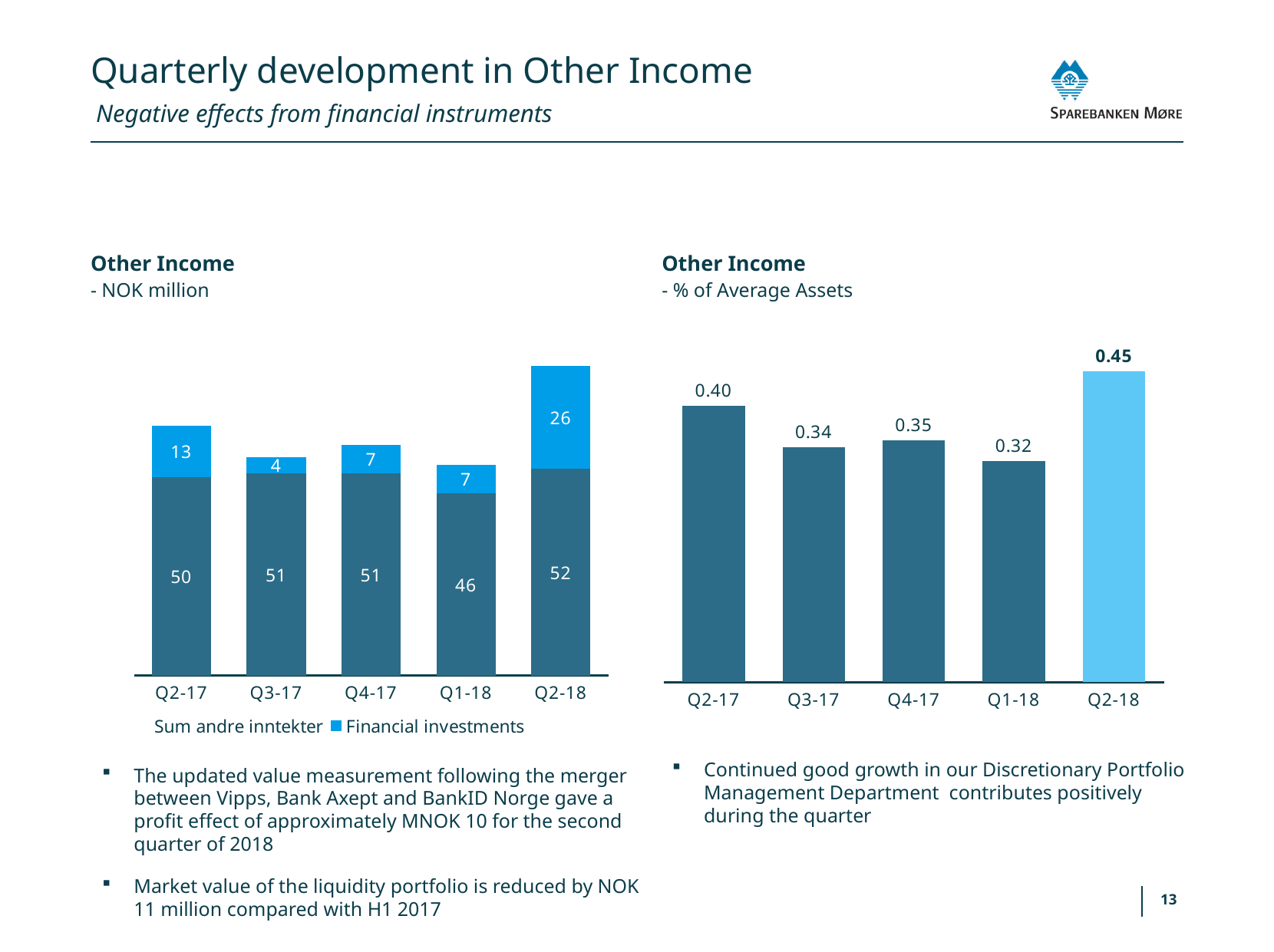
In the left chart (Other Income - NOK million), what is the total of the stacked bar for Q2-18? 78 In the left chart (Other Income - NOK million), what is the Financial investments value for Q2-18? 26 In the right chart (Other Income - % of Average Assets), what is the difference between the Q2-18 and Q2-17 values? 0.05 In the right chart (Other Income - % of Average Assets), which quarter has the highest value? Q2-18 In the left chart (Other Income - NOK million), what is the total of the stacked bar for Q2-17? 63 What kind of chart is the right chart (Other Income - % of Average Assets)? Bar chart In the left chart (Other Income - NOK million), how many series does the legend list? 2 In the right chart (Other Income - % of Average Assets), which quarter has the lowest value? Q1-18 In the left chart (Other Income - NOK million), which quarter has the lowest Financial investments value? Q3-17 In the right chart (Other Income - % of Average Assets), what is the value for Q4-17? 0.35